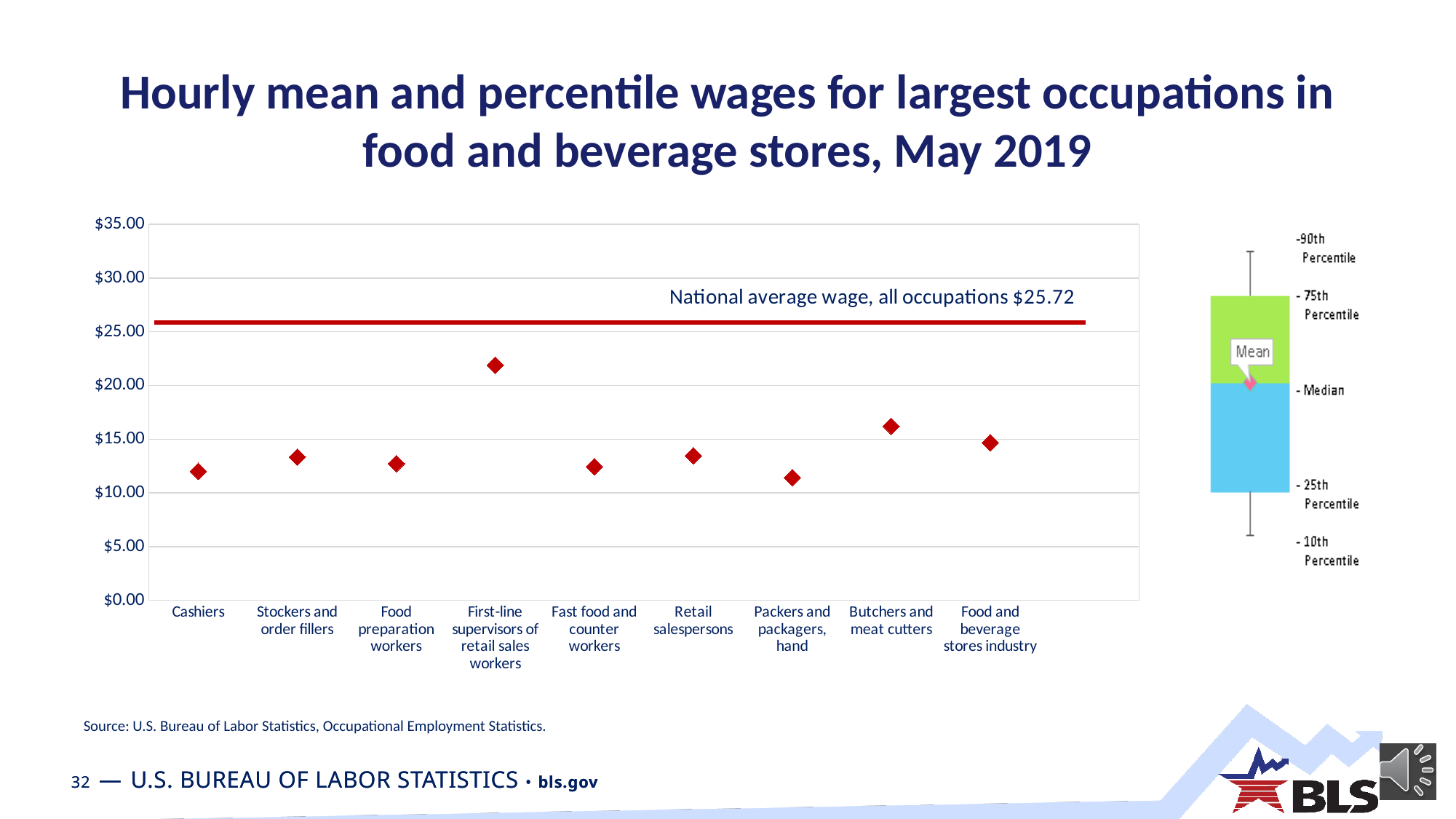
Is the hourly mean wage for Cashiers greater or less than $10.00? greater Is the hourly mean wage for First-line supervisors of retail sales workers greater or less than $25.00? less Which has a higher hourly mean wage, Cashiers or First-line supervisors of retail sales workers? First-line supervisors of retail sales workers What does the horizontal red line on the chart represent? National average wage, all occupations $25.72 Which occupation has the highest hourly mean wage on the chart? First-line supervisors of retail sales workers Is the hourly mean wage for Packers and packagers, hand greater or less than $15.00? less What kind of chart is used to show the hourly mean wages? Scatter (dot) chart How many occupation categories are plotted on the chart? 9 Which has a higher hourly mean wage, Butchers and meat cutters or Retail salespersons? Butchers and meat cutters What is the national average wage for all occupations shown on the chart? $25.72